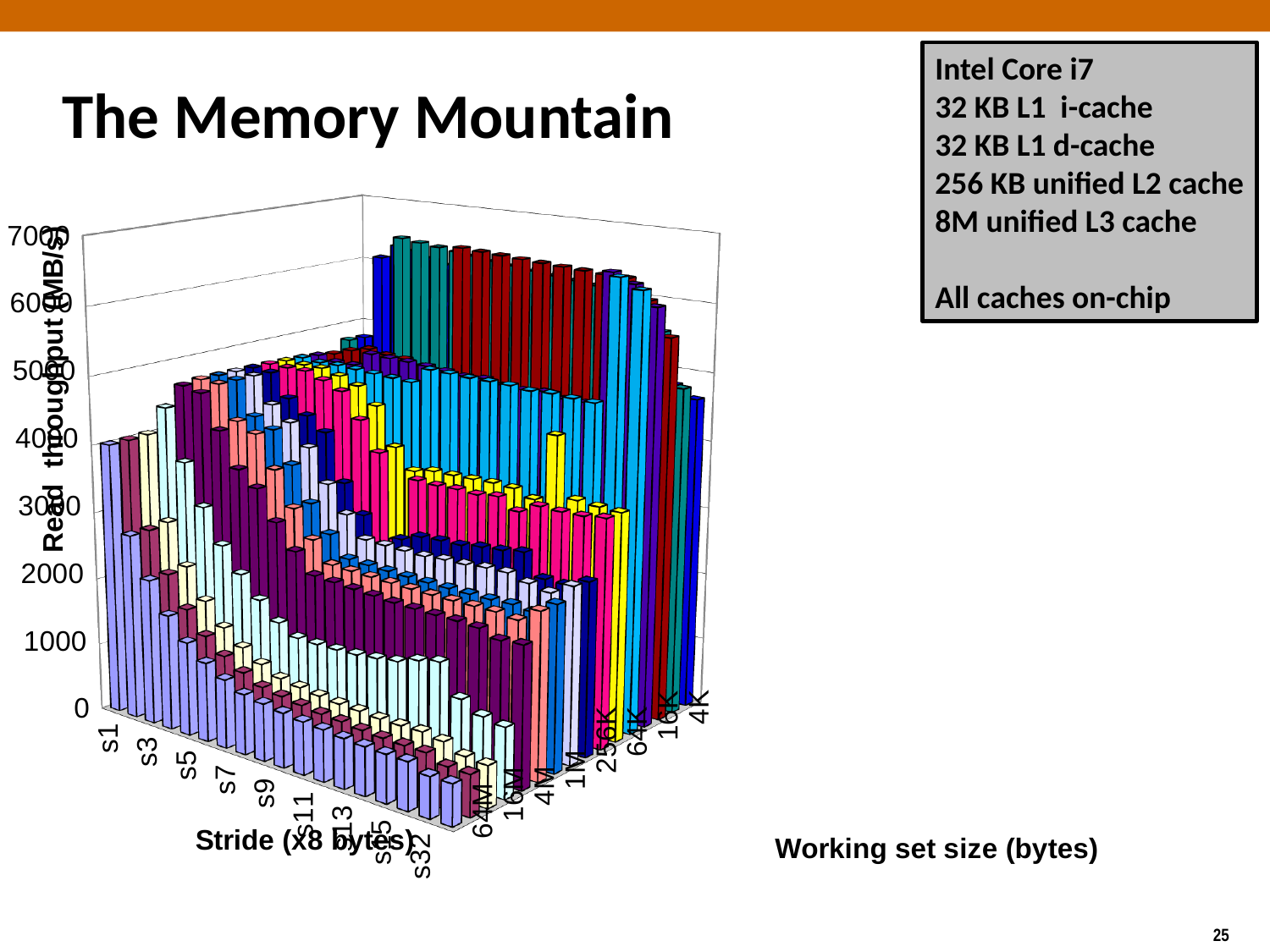
What is the title of the chart on the slide? The Memory Mountain What is the interval between tick marks on the vertical axis of the chart? 1000 How many working set size labels are shown along the working set size axis of the chart? 8 What is the highest value shown on the vertical axis of the chart? 7000 What is the smallest working set size labelled on the chart? 4K What kind of chart is shown on the slide? 3D bar chart How many stride labels are shown along the stride axis of the chart? 9 For a working set size of 64M, does read throughput rise or fall as the stride increases from s1 to s32? fall Is the read throughput for stride s32 at working set size 64M greater or less than 1000 MB/s? less What is the label of the vertical axis of the chart? Read throughput (MB/s) What is the largest working set size labelled on the chart? 64M